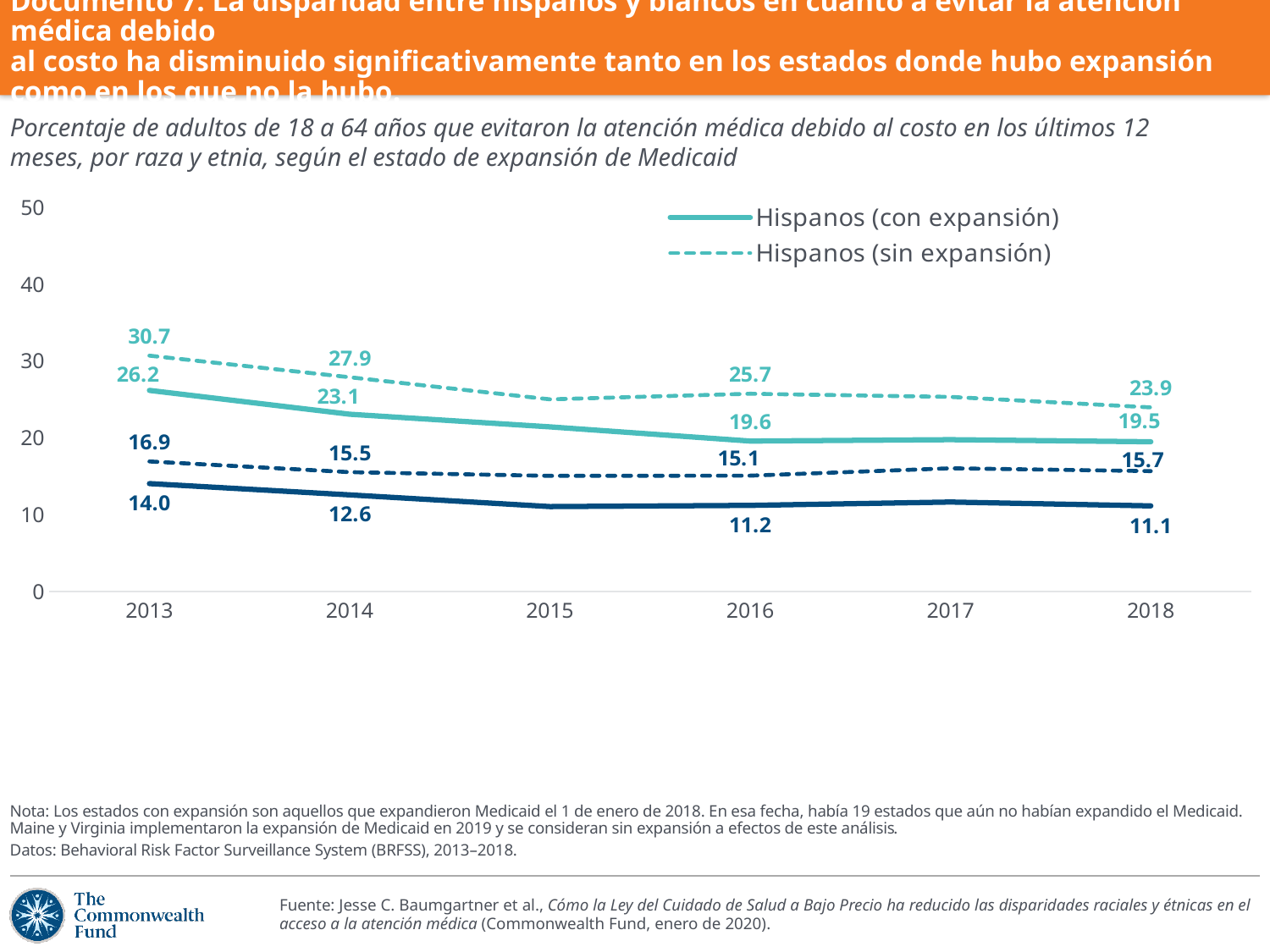
What is the value for Hispanos (con expansión) in 2018? 19.5 What is the value for Hispanos (con expansión) in 2014? 23.1 Is the value for Hispanos (con expansión) in 2015 greater or less than 20? greater How many series does the legend list? 2 What is the difference between Hispanos (sin expansión) and Hispanos (con expansión) in 2013? 4.5 How many years are shown on the x axis? 6 By how much did the value for Hispanos (con expansión) fall from 2013 to 2018? 6.7 What kind of chart is shown on the slide? line chart What is the value for Hispanos (sin expansión) in 2016? 25.7 Which is larger in 2018, Hispanos (con expansión) or Hispanos (sin expansión)? Hispanos (sin expansión) What is the value for Hispanos (sin expansión) in 2013? 30.7 In which year is the value for Hispanos (sin expansión) highest? 2013